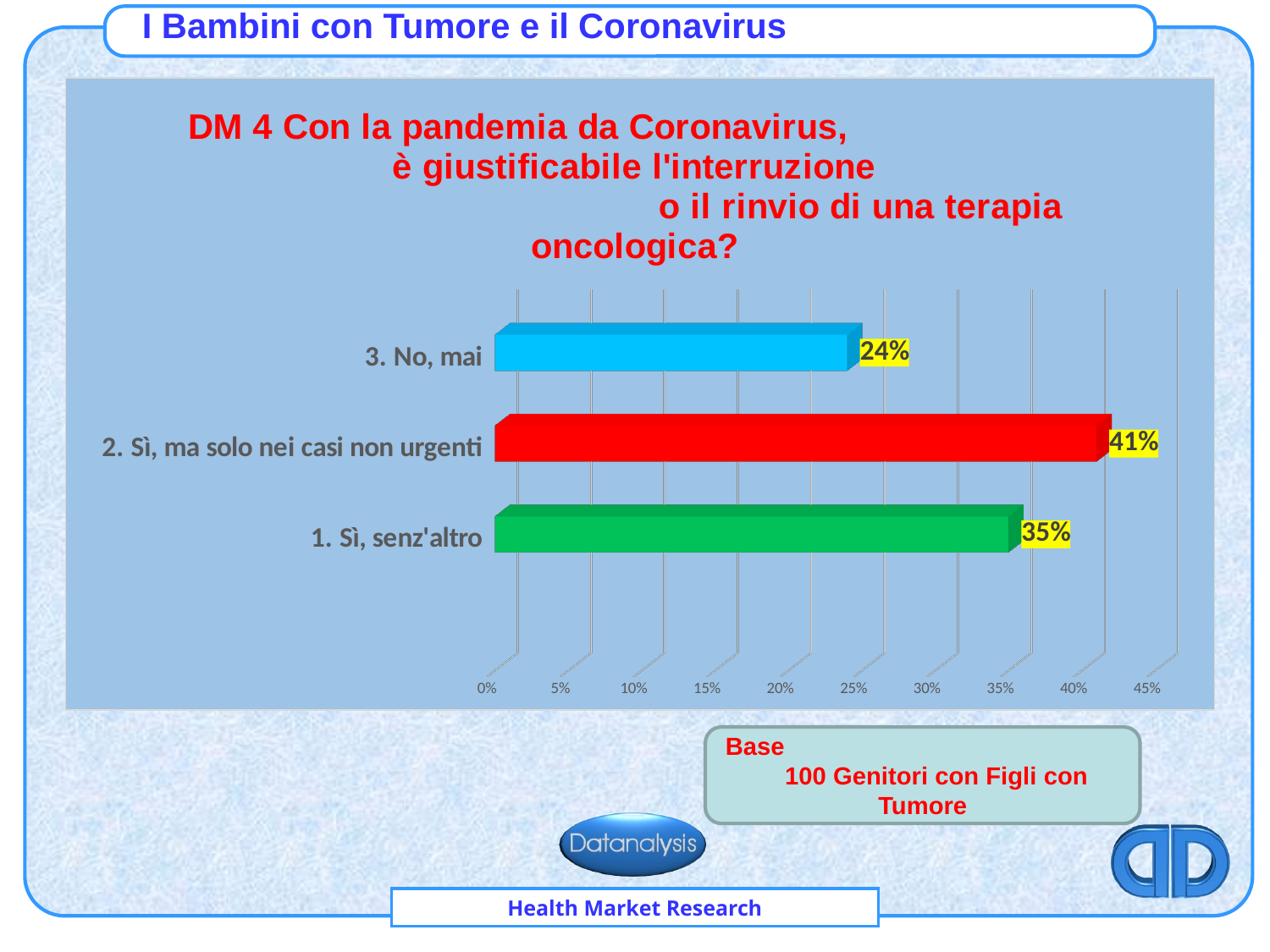
How many categories are shown in the chart? 3 What kind of chart is shown on the slide? bar chart What is the value for "3. No, mai"? 24% What is the value for "1. Sì, senz'altro"? 35% Which category has the lowest value? 3. No, mai What is the difference between the values for "2. Sì, ma solo nei casi non urgenti" and "1. Sì, senz'altro"? 6% Is the value for "3. No, mai" greater or less than 30%? less Which is larger, the value for "1. Sì, senz'altro" or the value for "3. No, mai"? 1. Sì, senz'altro What colour is the bar for "2. Sì, ma solo nei casi non urgenti"? red Which category has the highest value? 2. Sì, ma solo nei casi non urgenti What is the value for "2. Sì, ma solo nei casi non urgenti"? 41% What is the difference between the values for "2. Sì, ma solo nei casi non urgenti" and "3. No, mai"? 17%